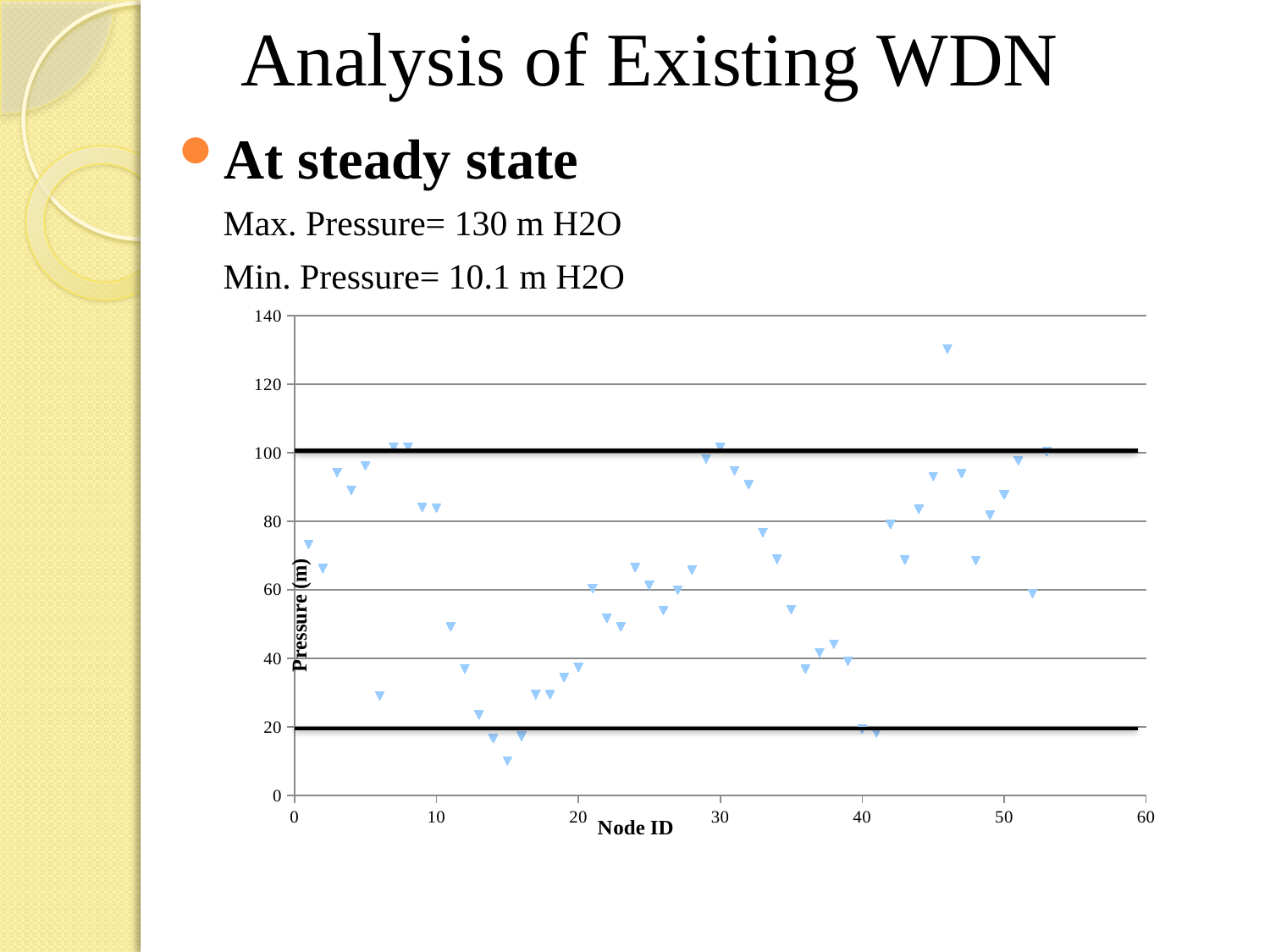
Is the pressure plotted for Node ID 1 greater or less than 60? greater Is the pressure plotted for Node ID 15 greater or less than 20? less Is the lowest plotted pressure value in the chart greater or less than 20? less Which has the higher plotted pressure, Node ID 46 or Node ID 15? Node ID 46 What kind of chart is shown on the slide? Scatter chart What is the title of the horizontal axis of the chart? Node ID What is the title of the vertical axis of the chart? Pressure (m)